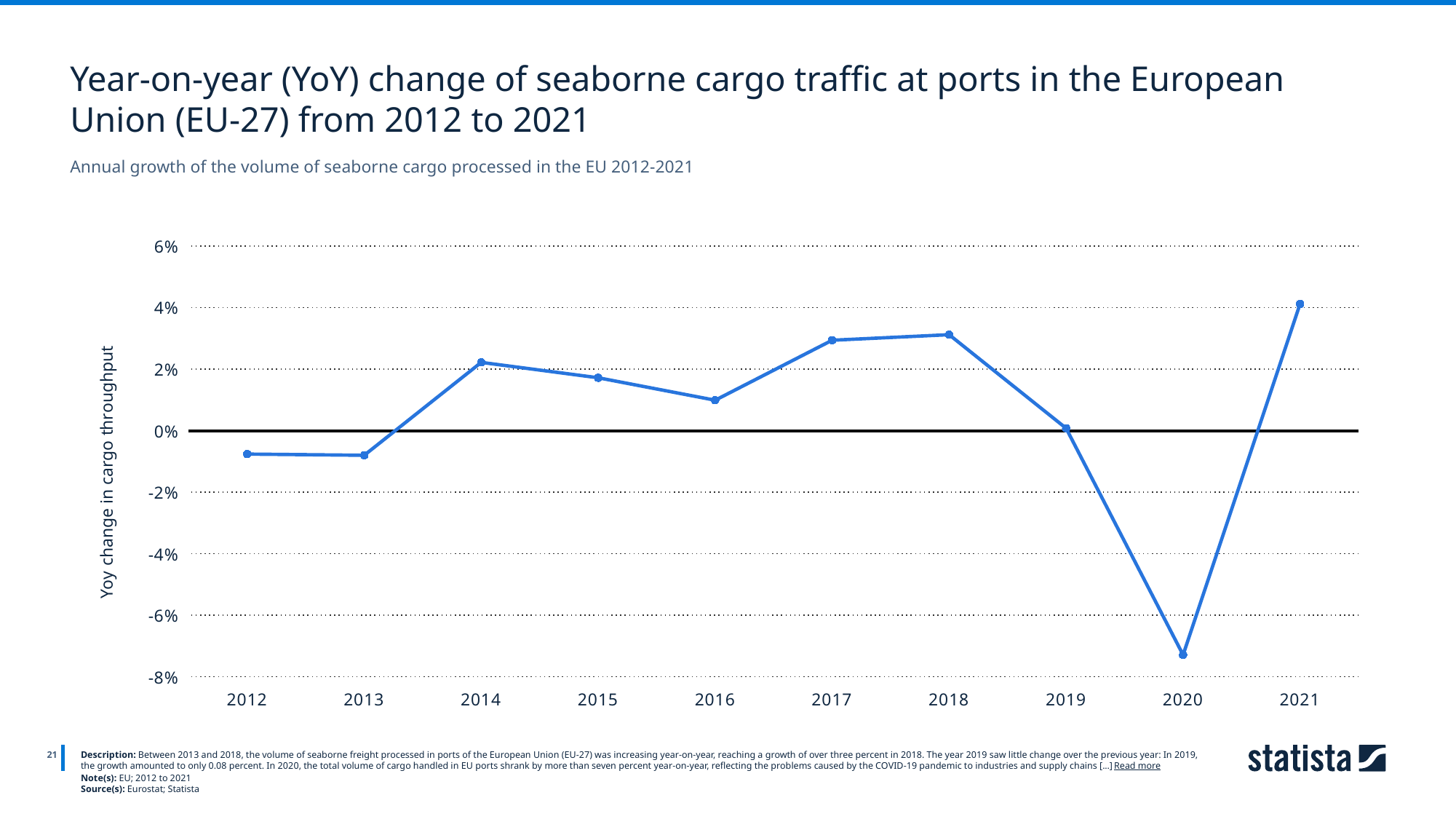
Which year has the highest YoY change in cargo throughput? 2021 Which year has the lowest YoY change in cargo throughput? 2020 Do the values rise or fall from 2016 to 2018? rise Is the value for 2021 greater or less than 2%? greater Which year has the larger YoY change, 2014 or 2015? 2014 Is the value for 2020 greater or less than -6%? less Is the value for 2016 greater or less than 2%? less What is the label on the y axis? Yoy change in cargo throughput What kind of chart is shown on the slide? line chart How many years are plotted on the x axis? 10 Which year has the larger YoY change, 2016 or 2017? 2017